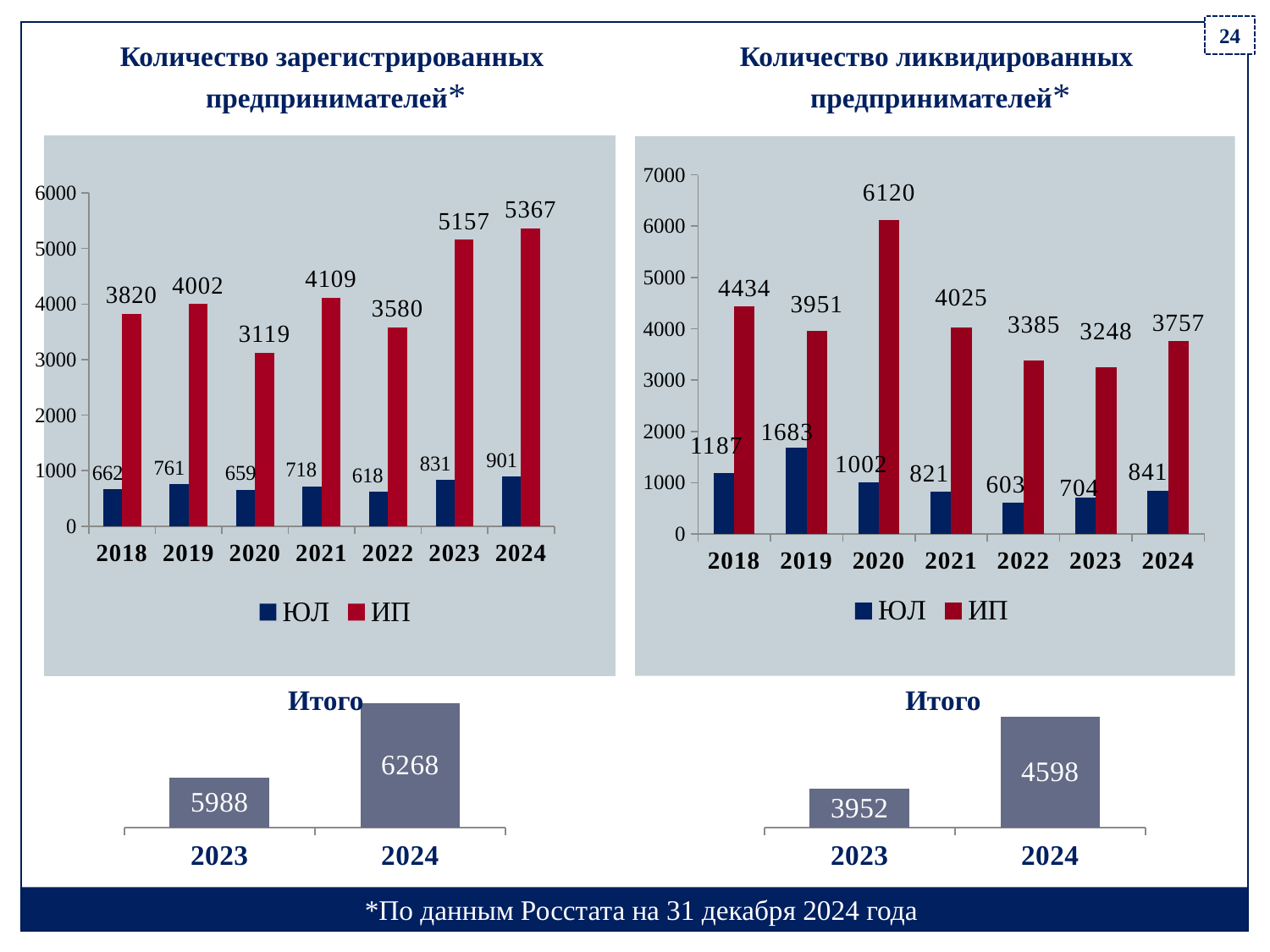
In the chart titled "Количество ликвидированных предпринимателей", which year has the larger ИП value, 2018 or 2021? 2018 What are the two legend entries in the chart titled "Количество зарегистрированных предпринимателей"? ЮЛ and ИП In the "Итого" chart on the left (below the registered entrepreneurs chart), what is the difference between the 2024 and 2023 values? 280 In the chart titled "Количество зарегистрированных предпринимателей", do the ЮЛ values rise or fall from 2022 to 2024? Rise What kind of chart is the chart titled "Количество зарегистрированных предпринимателей"? Bar chart In the chart titled "Количество зарегистрированных предпринимателей", which year has the highest ИП value? 2024 How many years are shown on the x axis of the chart titled "Количество зарегистрированных предпринимателей"? 7 In the "Итого" chart on the right (below the liquidated entrepreneurs chart), what is the value for 2023? 3952 In the chart titled "Количество ликвидированных предпринимателей", what is the value for ЮЛ in 2019? 1683 In the chart titled "Количество зарегистрированных предпринимателей", what is the value for ИП in 2021? 4109 In the chart titled "Количество ликвидированных предпринимателей", which year has the lowest ЮЛ value? 2022 How many series does the legend list in the chart titled "Количество ликвидированных предпринимателей"? 2